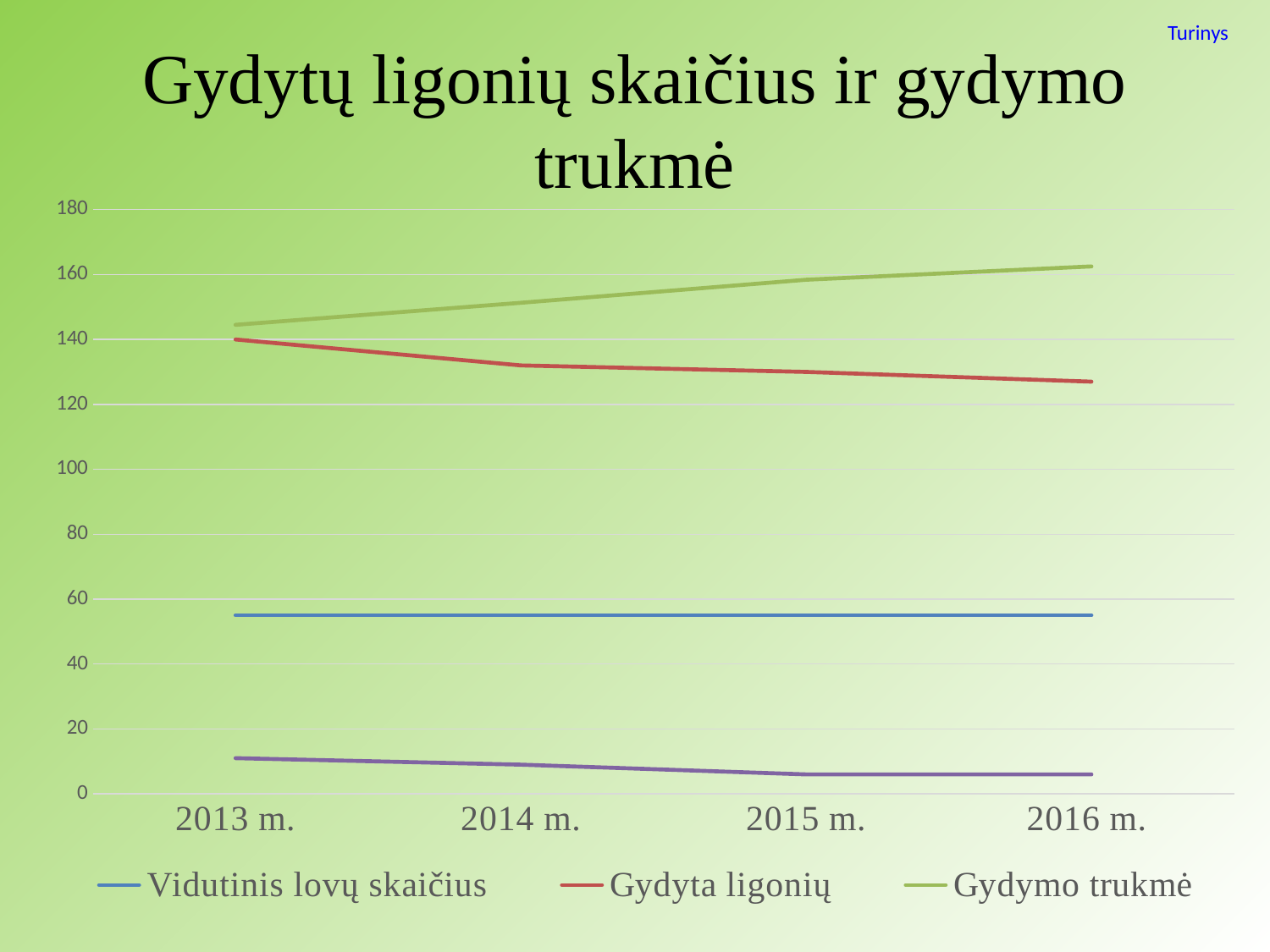
What is the title of the chart on the slide? Gydytų ligonių skaičius ir gydymo trukmė Is the value for Vidutinis lovų skaičius in 2013 m. greater or less than 60? less Is the value for Gydyta ligonių in 2016 m. greater or less than 140? less How many years are plotted along the x axis of the chart? 4 How many series does the chart legend list? 3 Is the value for Gydymo trukmė in 2013 m. greater or less than 140? greater Does the Gydymo trukmė line rise or fall from 2013 m. to 2016 m.? rise Does the Gydyta ligonių line rise or fall from 2013 m. to 2016 m.? fall In 2016 m., which is larger: Gydymo trukmė or Gydyta ligonių? Gydymo trukmė What kind of chart is shown on the slide? line chart In which year does the Gydymo trukmė line reach its highest value? 2016 m. In which year does the Gydyta ligonių line reach its lowest value? 2016 m.